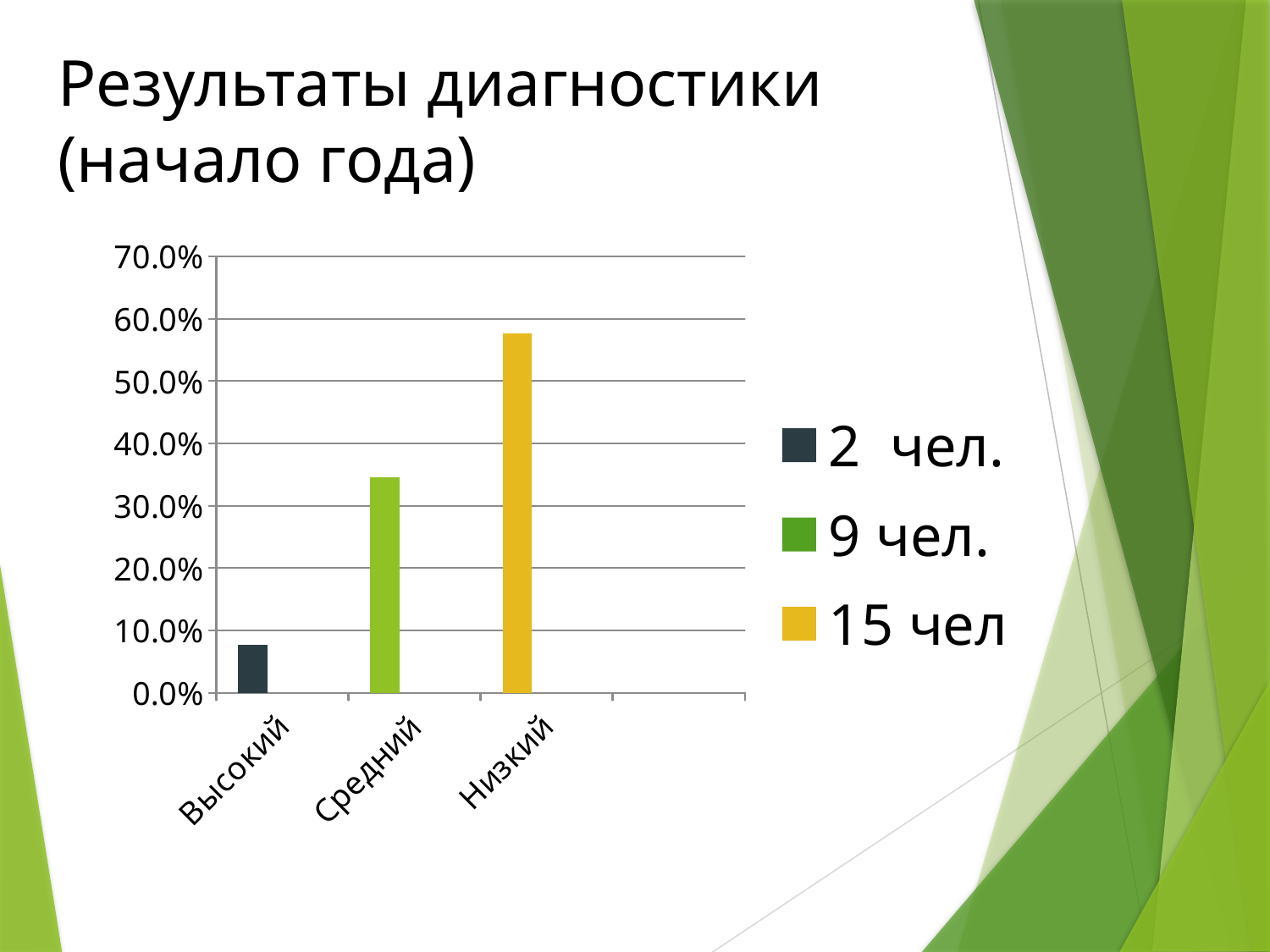
How many entries does the chart's legend list? 3 Which legend entry is shown with the yellow colour? 15 чел Do the bar values rise or fall moving from Высокий to Низкий along the x axis? rise Is the value for Высокий greater or less than 10.0%? less Which category has the lowest bar in the chart? Высокий Is the value for Низкий greater or less than 50.0%? greater Which is larger, the value for Средний or the value for Высокий? Средний What kind of chart is shown on the slide? bar chart How many categories are shown on the x axis of the chart? 3 Is the value for Средний greater or less than 30.0%? greater Which category has the highest bar in the chart? Низкий What is the title of the slide containing the chart? Результаты диагностики (начало года)